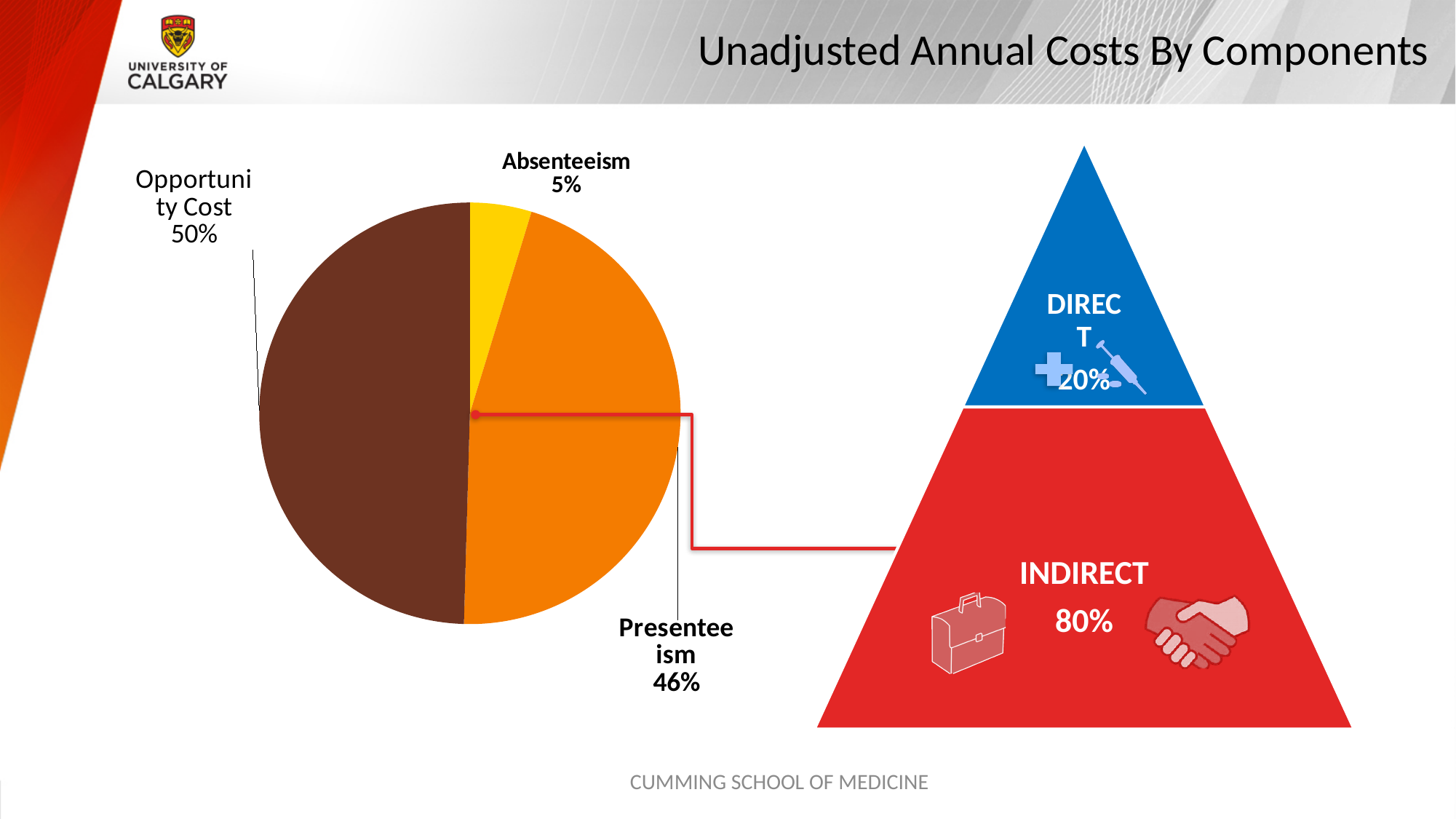
In the pie chart, which is larger: Presenteeism or Absenteeism? Presenteeism In the pie chart, what share is labelled for Absenteeism? 5% In the pie chart, what is the difference in percentage points between Presenteeism and Absenteeism? 41 percentage points Which slice of the pie chart is the smallest? Absenteeism What type of chart is shown on the left of the slide? pie chart What colour is the Opportunity Cost slice in the pie chart? brown In the pie chart, what share is labelled for Opportunity Cost? 50% In the pie chart, what share is labelled for Presenteeism? 46% What is the title of the slide containing the pie chart? Unadjusted Annual Costs By Components Which slice of the pie chart is the largest? Opportunity Cost In the pie chart, what is the difference in percentage points between Opportunity Cost and Presenteeism? 4 percentage points How many slices does the pie chart have? 3